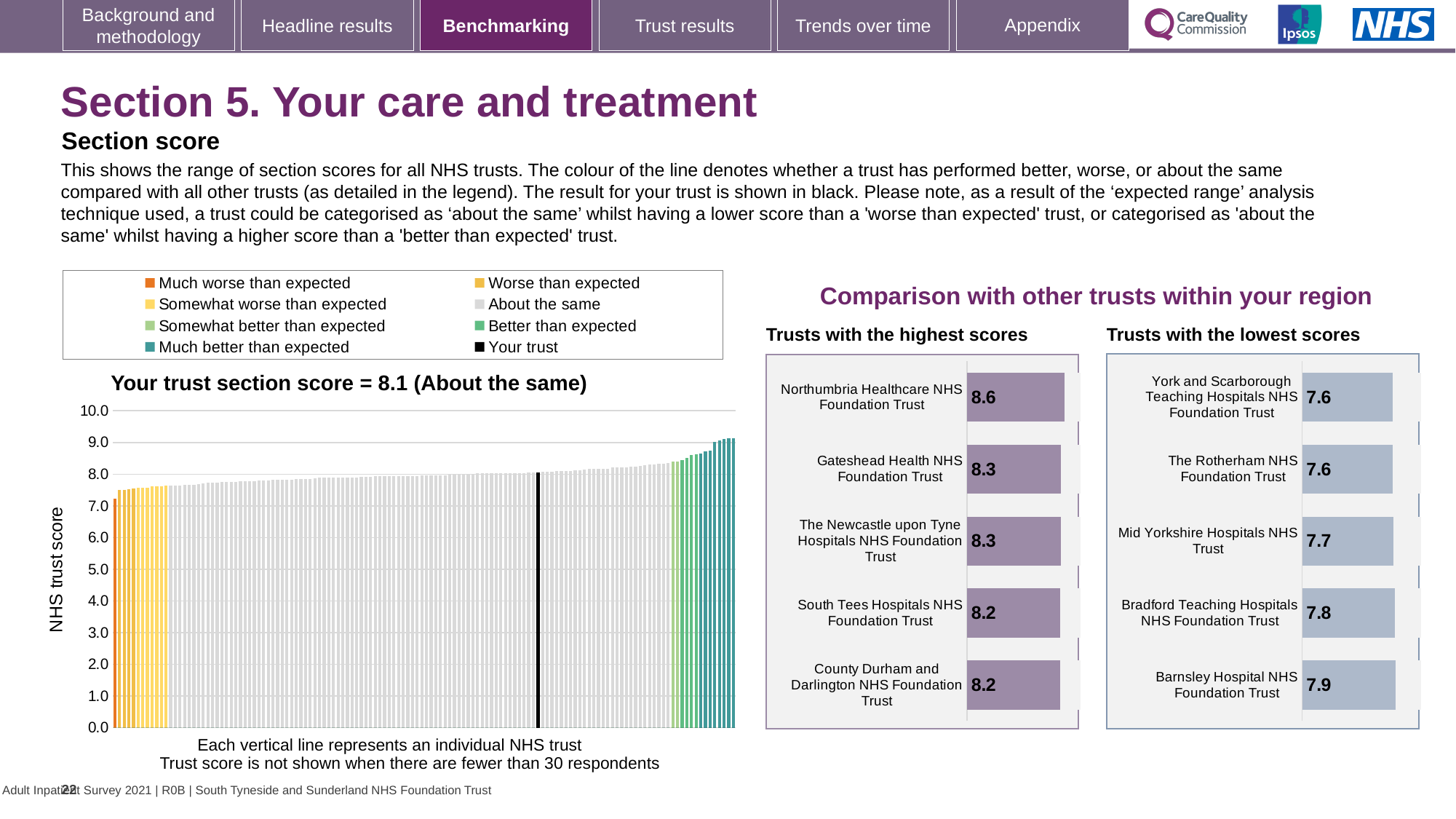
In the 'Trusts with the highest scores' chart, which trust has the highest score? Northumbria Healthcare NHS Foundation Trust In the main section score chart on the left, what is the section score for your trust? 8.1 How many entries does the legend of the main section score chart on the left list? 8 In the 'Trusts with the lowest scores' chart, which trust has the highest score? Barnsley Hospital NHS Foundation Trust How many trusts are listed in the 'Trusts with the lowest scores' chart? 5 In the 'Trusts with the lowest scores' chart, what is the score for Mid Yorkshire Hospitals NHS Trust? 7.7 In the 'Trusts with the highest scores' chart, what is the score for Northumbria Healthcare NHS Foundation Trust? 8.6 In the 'Trusts with the lowest scores' chart, what is the difference between the scores of Barnsley Hospital NHS Foundation Trust and The Rotherham NHS Foundation Trust? 0.3 In the main section score chart on the left, is the value of the lowest (leftmost) bar greater or less than 8.0? less In the 'Trusts with the highest scores' chart, what is the score for South Tees Hospitals NHS Foundation Trust? 8.2 In the 'Trusts with the lowest scores' chart, which has the larger score: Bradford Teaching Hospitals NHS Foundation Trust or Mid Yorkshire Hospitals NHS Trust? Bradford Teaching Hospitals NHS Foundation Trust In the 'Trusts with the highest scores' chart, what is the difference between the scores of Northumbria Healthcare NHS Foundation Trust and County Durham and Darlington NHS Foundation Trust? 0.4